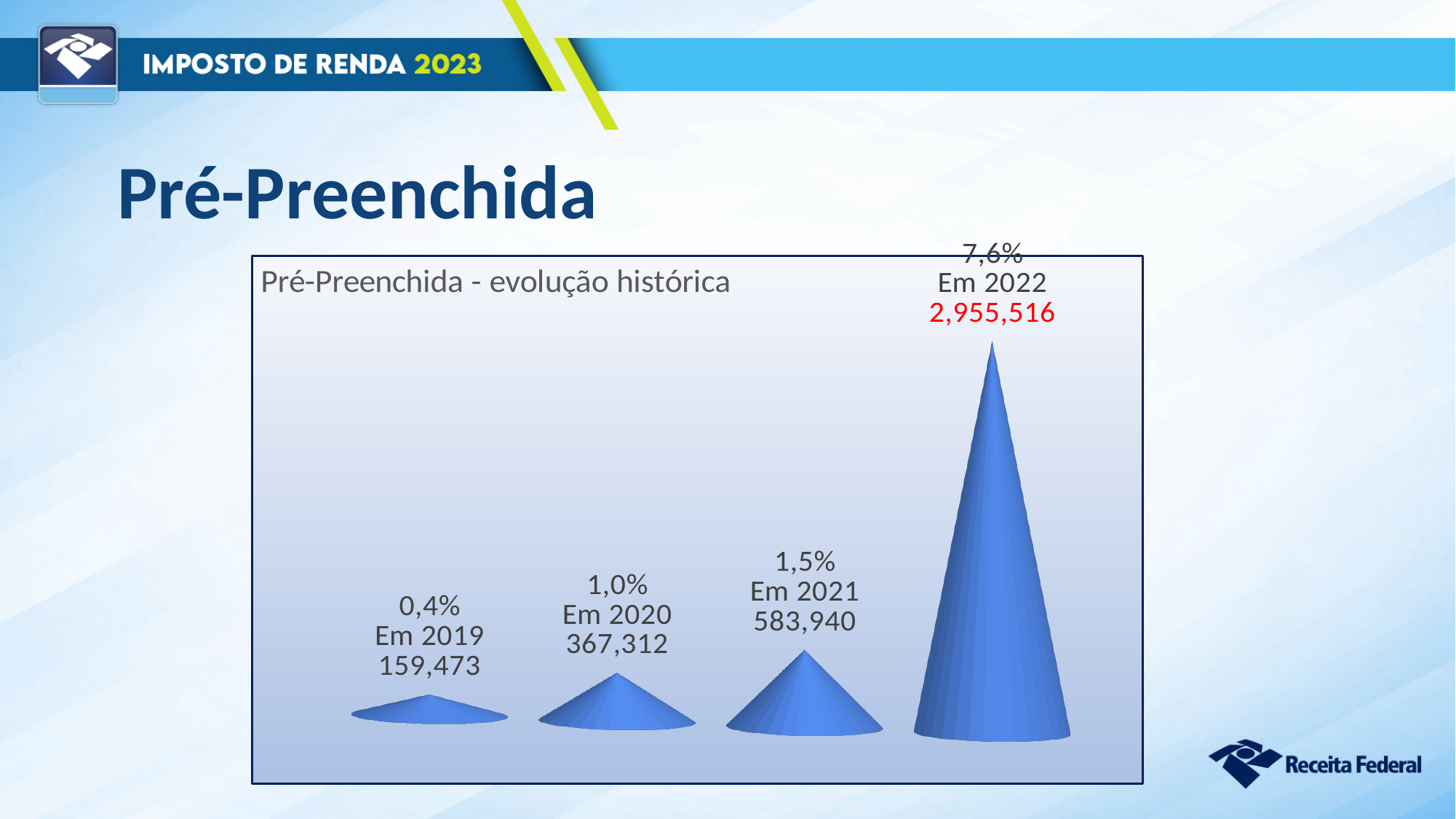
How many years are plotted in the chart? 4 What is the difference between the values for Em 2020 and Em 2019? 207,839 What value is shown for Em 2019 in the chart? 159,473 Which year has the highest value in the chart? Em 2022 What percentage is shown above Em 2020? 1,0% What value is shown for Em 2022 in the chart? 2,955,516 What percentage is shown above Em 2021? 1,5% What is the title of the chart? Pré-Preenchida - evolução histórica Which is larger, the value for Em 2021 or the value for Em 2020? Em 2021 Which year has the lowest value in the chart? Em 2019 Do the values rise or fall from Em 2019 to Em 2022? rise What is the difference between the values for Em 2022 and Em 2021? 2,371,576